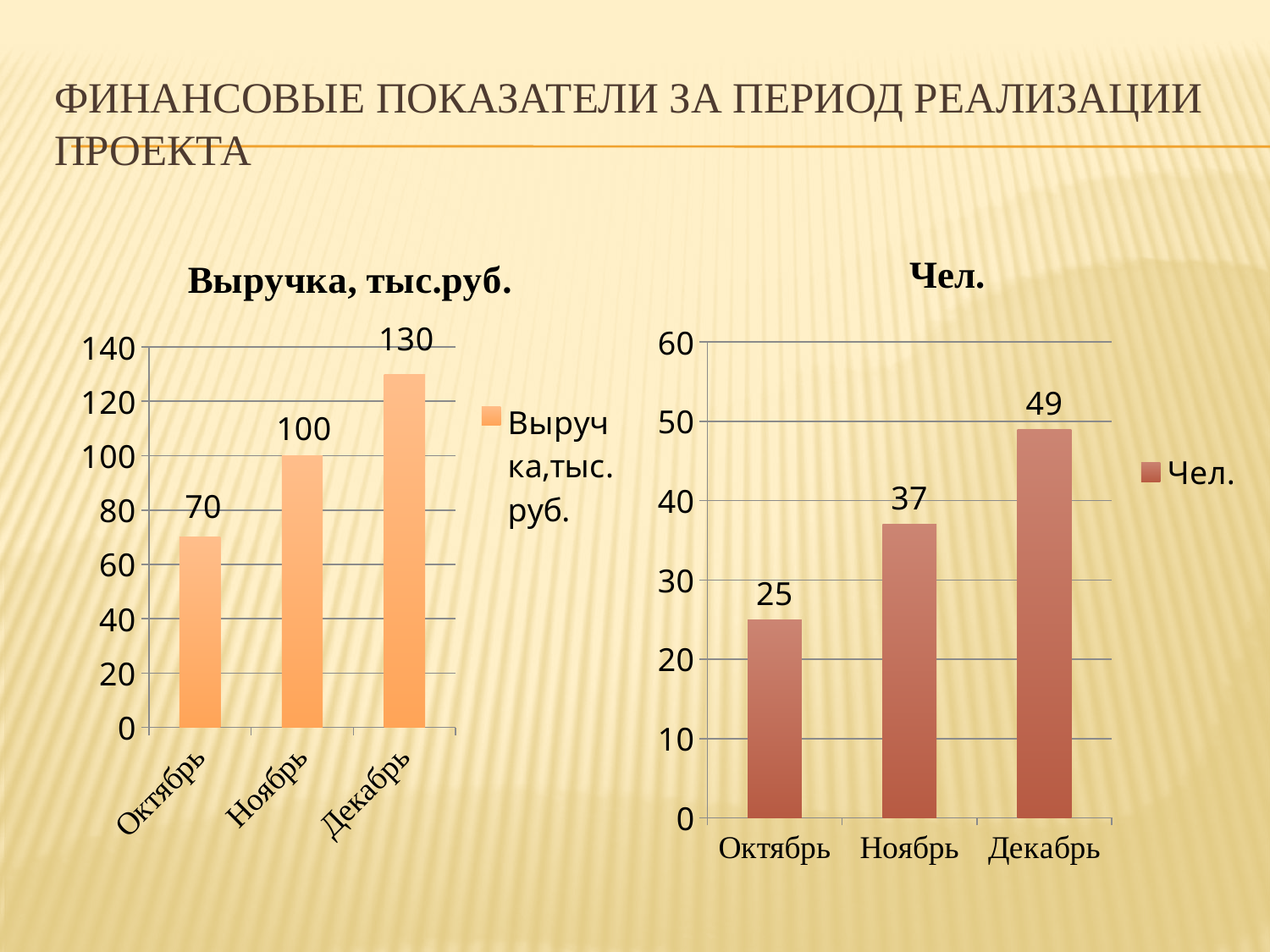
In the chart titled "Чел.", what is the difference between the values for Ноябрь and Октябрь? 12 In the chart titled "Чел.", which month has the lowest value? Октябрь How many series does the legend list in the chart titled "Выручка, тыс.руб."? 1 In the chart titled "Выручка, тыс.руб.", what is the value for Ноябрь? 100 In the chart titled "Чел.", what is the value for Декабрь? 49 In the chart titled "Выручка, тыс.руб.", do the values rise or fall from Октябрь to Декабрь? rise In the chart titled "Выручка, тыс.руб.", is the value for Октябрь greater or less than 80? less In the chart titled "Выручка, тыс.руб.", which month has the highest value? Декабрь In the chart titled "Выручка, тыс.руб.", what is the difference between the values for Декабрь and Октябрь? 60 What kind of chart is the chart titled "Чел."? bar chart In the chart titled "Чел.", which is larger, the value for Ноябрь or the value for Декабрь? Декабрь How many categories are shown in the chart titled "Чел."? 3